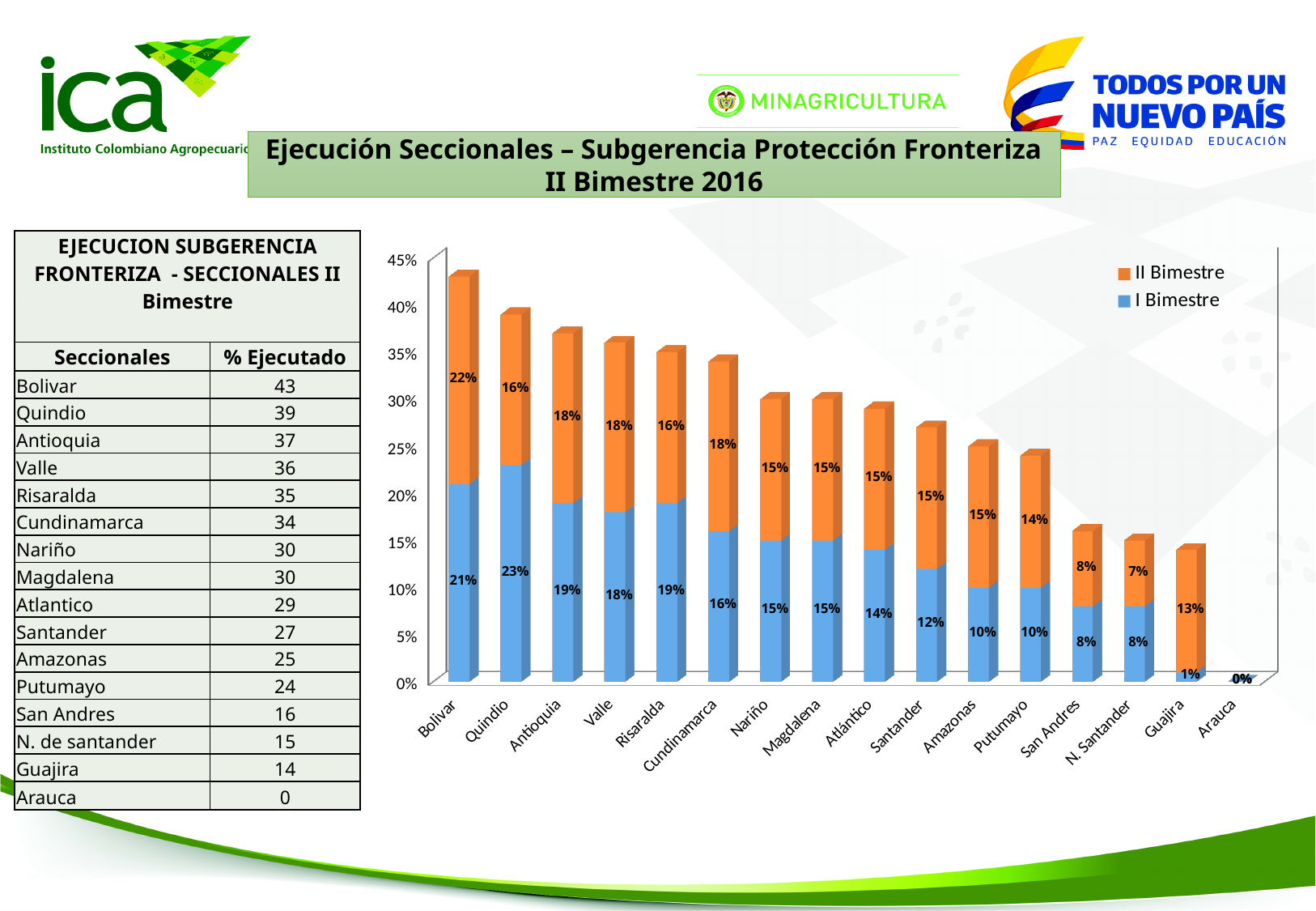
What is the difference between the I Bimestre values for Bolivar and Santander? 9% What is the total of the stacked bar for Antioquia? 37% What is the I Bimestre value for Quindio? 23% What is the II Bimestre value for Guajira? 13% Which colour represents the II Bimestre series in the chart? Orange How many series does the chart legend list? 2 What is the II Bimestre value for Bolivar? 22% What kind of chart is shown on the slide? Stacked bar chart Which is larger, the II Bimestre value for Cundinamarca or the II Bimestre value for Putumayo? Cundinamarca Which category has the highest I Bimestre value? Quindio Which category has the lowest II Bimestre value? Arauca How many categories are shown on the x axis of the chart? 16